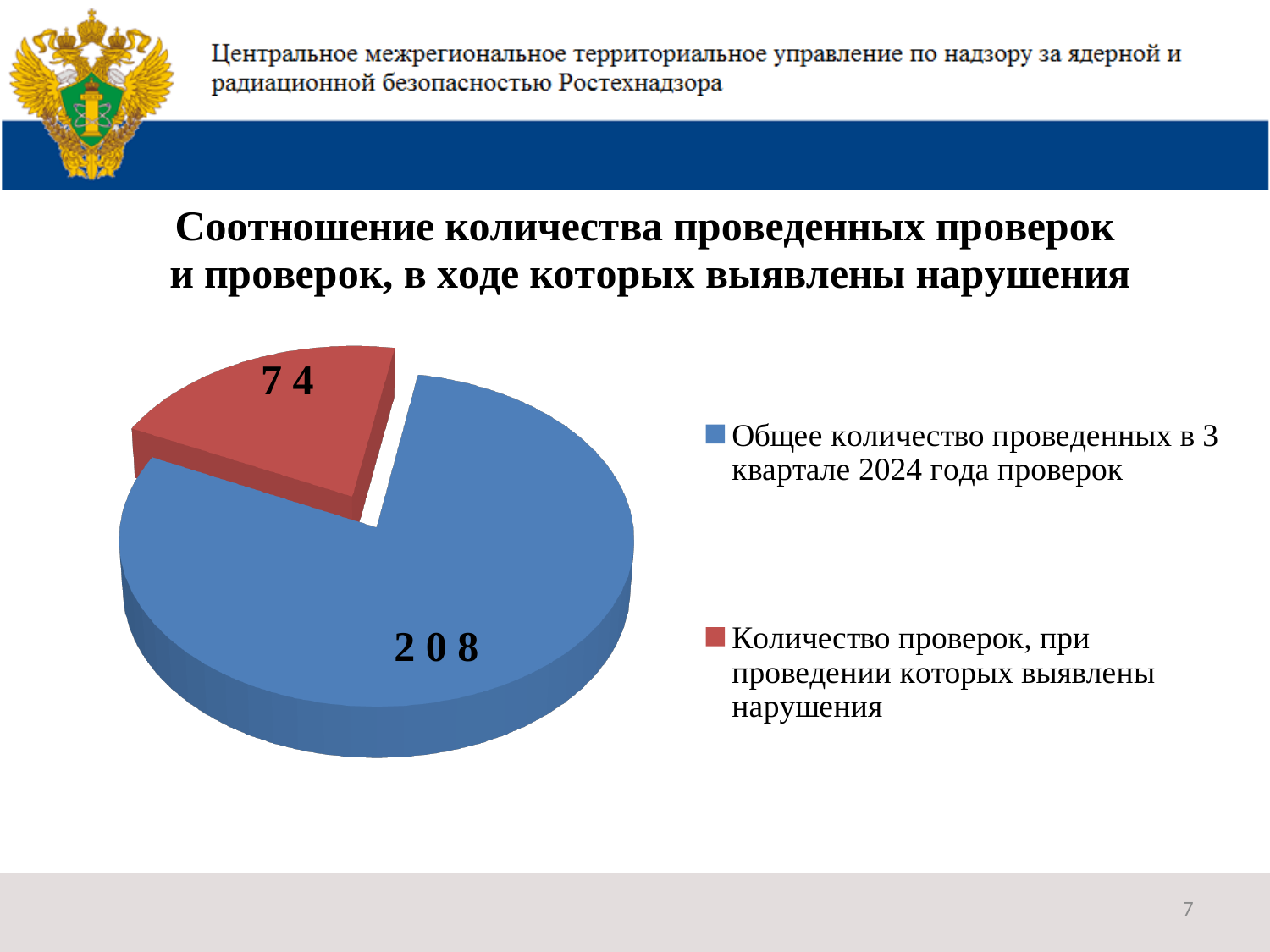
What is the difference between the total number of inspections (208) and the number of inspections with violations (74)? 134 What is the value for "Общее количество проведенных в 3 квартале 2024 года проверок"? 208 What colour is the slice representing "Количество проверок, при проведении которых выявлены нарушения"? Red What is the title of the chart on the slide? Соотношение количества проведенных проверок и проверок, в ходе которых выявлены нарушения Which slice of the pie chart is the smallest? Количество проверок, при проведении которых выявлены нарушения Which is larger: the value for the blue slice or the value for the red slice? The blue slice (208) What type of chart is shown on the slide? Pie chart How many entries does the legend list? 2 How many slices does the pie chart have? 2 Which slice of the pie chart is the largest? Общее количество проведенных в 3 квартале 2024 года проверок What is the value for "Количество проверок, при проведении которых выявлены нарушения"? 74 What is the sum of the two values shown on the pie chart? 282